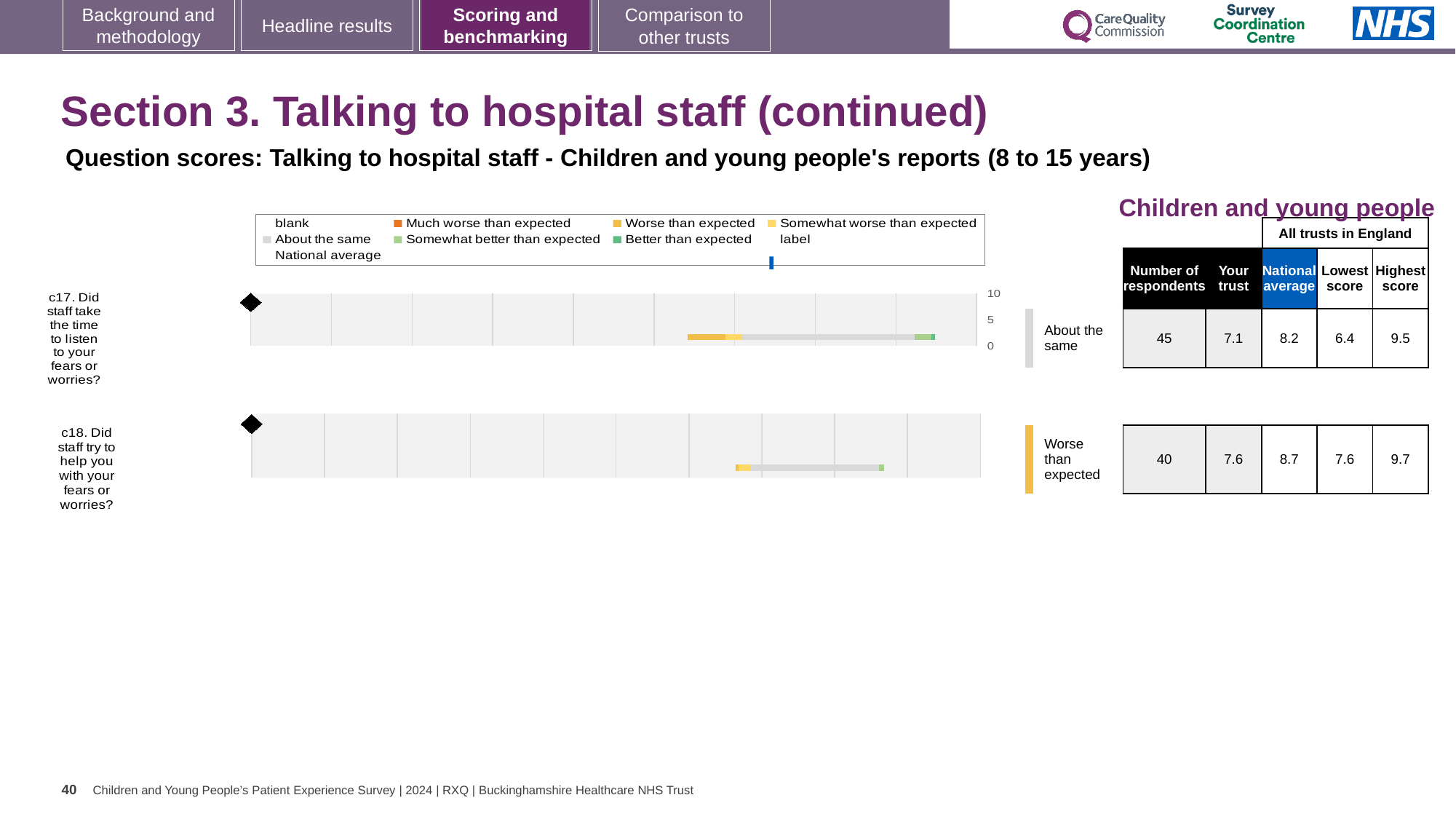
What is the highest score among all trusts in England for c18? 9.7 How many respondents answered c17? 45 What benchmark category is shown for c17? About the same For c18, what is the difference between the national average and the 'Your trust' score? 1.1 What is the 'Your trust' score for c17 (Did staff take the time to listen to your fears or worries?)? 7.1 How many survey questions are plotted on the slide? 2 Which question has the higher 'Your trust' score, c17 or c18? c18 For c17, which is larger: the 'Your trust' score or the national average? National average What kind of chart is used to show the question scores for c17 and c18? bar chart What is the national average score for c18 (Did staff try to help you with your fears or worries?)? 8.7 For c17, what is the difference between the highest score and the lowest score among all trusts in England? 3.1 What benchmark category is shown for c18? Worse than expected